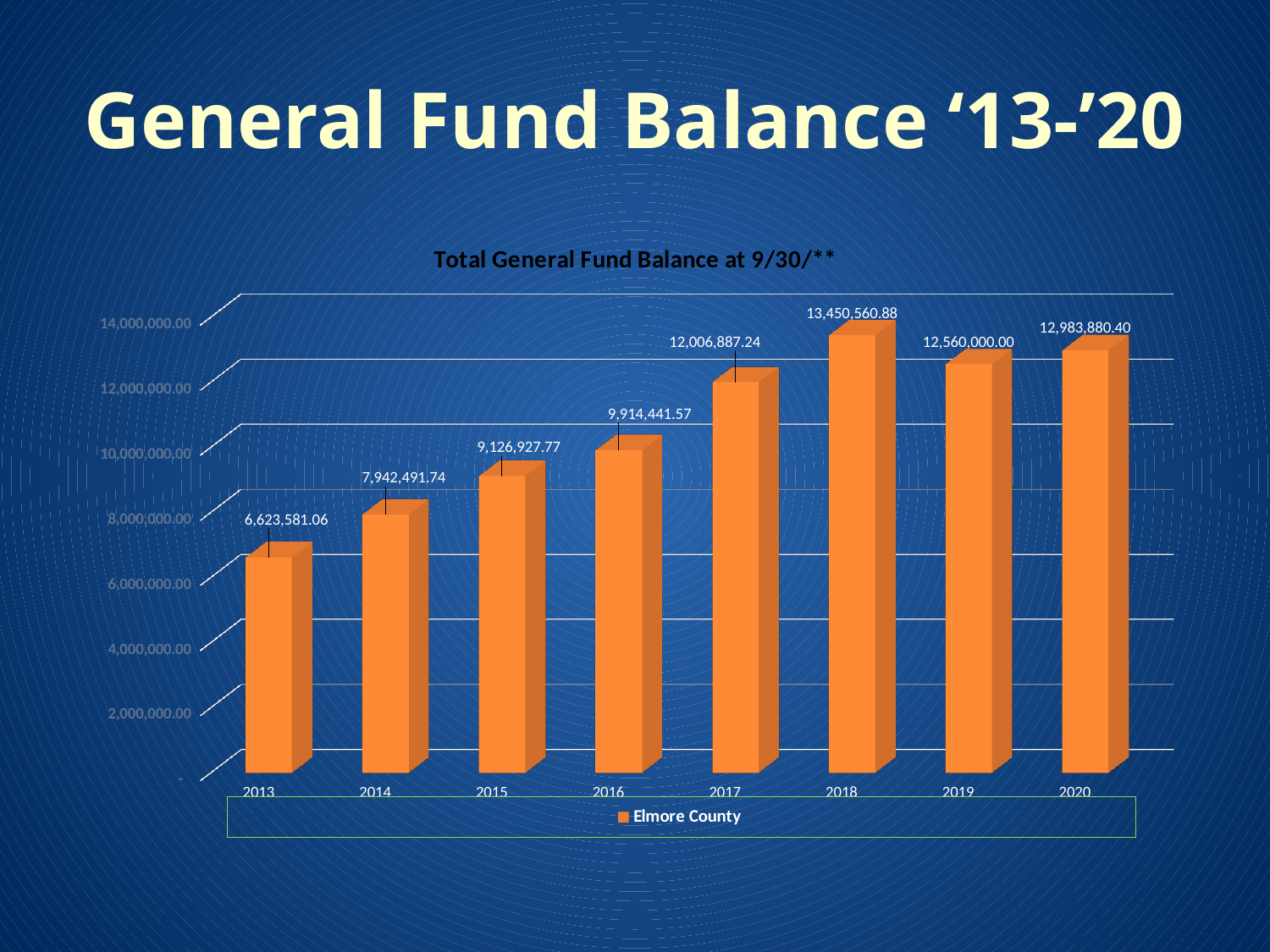
What kind of chart is shown on the slide? bar chart How many years are shown on the chart? 8 Is the general fund balance for 2016 greater or less than 10,000,000.00? less What is the total general fund balance for 2018? 13,450,560.88 Which year has a larger general fund balance, 2019 or 2020? 2020 What series name does the legend show? Elmore County Which year has the highest general fund balance? 2018 Which year has the lowest general fund balance? 2013 What is the total general fund balance for 2013? 6,623,581.06 What is the total general fund balance for 2020? 12,983,880.40 What is the difference between the 2018 and 2017 general fund balances? 1,443,673.64 What is the difference between the 2020 and 2019 general fund balances? 423,880.40